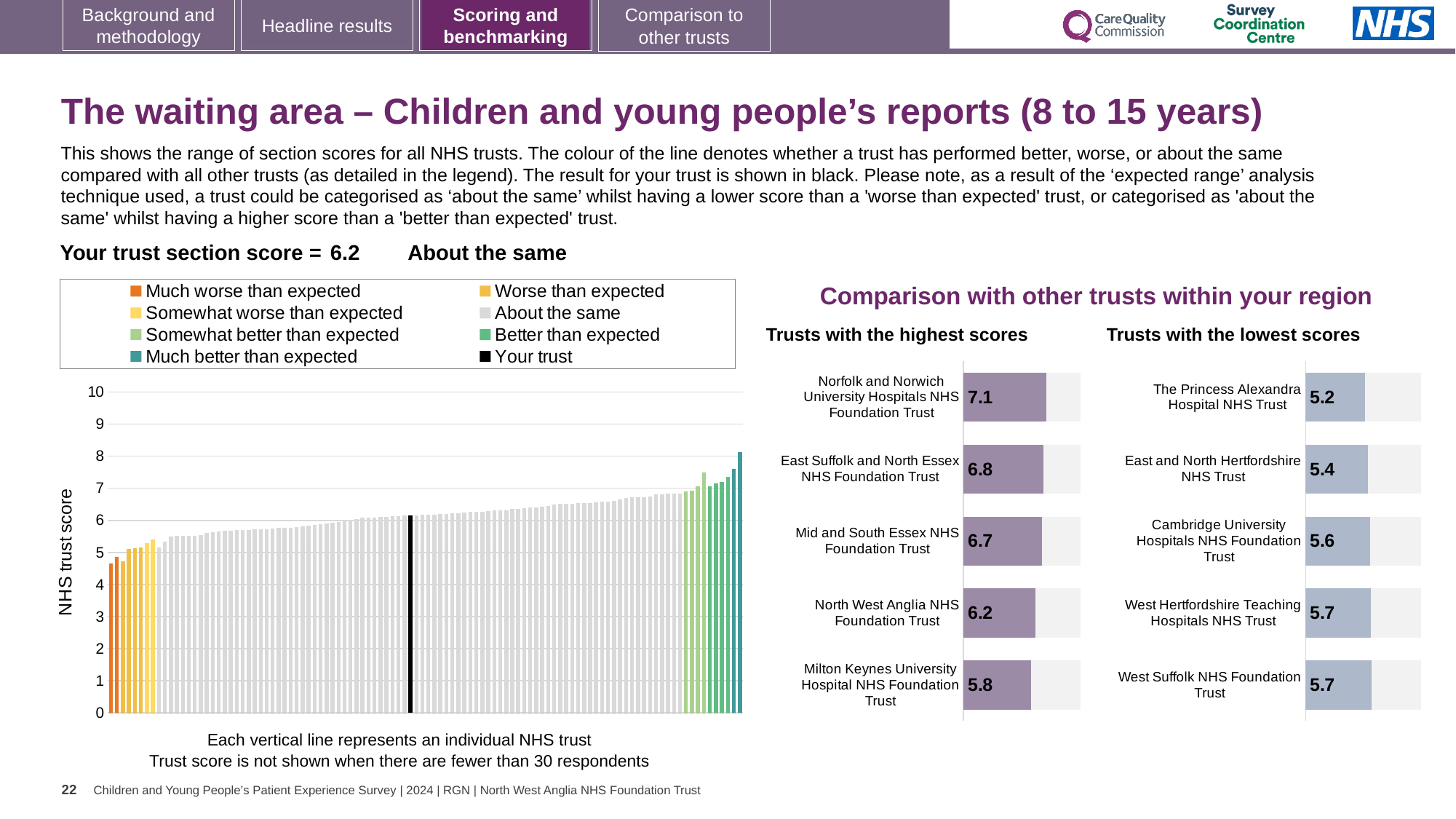
In the 'Trusts with the lowest scores' chart, what is the difference between the scores of West Suffolk NHS Foundation Trust and The Princess Alexandra Hospital NHS Trust? 0.5 In the 'Trusts with the highest scores' chart, what is the difference between the scores of Norfolk and Norwich University Hospitals NHS Foundation Trust and North West Anglia NHS Foundation Trust? 0.9 In the large chart on the left, is the value of the lowest bar greater or less than 5? less In the 'Trusts with the highest scores' chart, what is the score for Milton Keynes University Hospital NHS Foundation Trust? 5.8 In the 'Trusts with the highest scores' chart, what is the score for Norfolk and Norwich University Hospitals NHS Foundation Trust? 7.1 In the large chart on the left, do the trust scores rise or fall from left to right? Rise What kind of chart is the large chart on the left showing NHS trust scores? Bar chart How many entries does the legend above the large chart on the left list? 8 How many trusts are shown in the 'Trusts with the highest scores' chart? 5 In the 'Trusts with the lowest scores' chart, which has the higher score: East and North Hertfordshire NHS Trust or West Hertfordshire Teaching Hospitals NHS Trust? West Hertfordshire Teaching Hospitals NHS Trust In the 'Trusts with the lowest scores' chart, which trust has the lowest score? The Princess Alexandra Hospital NHS Trust In the 'Trusts with the lowest scores' chart, what is the score for Cambridge University Hospitals NHS Foundation Trust? 5.6